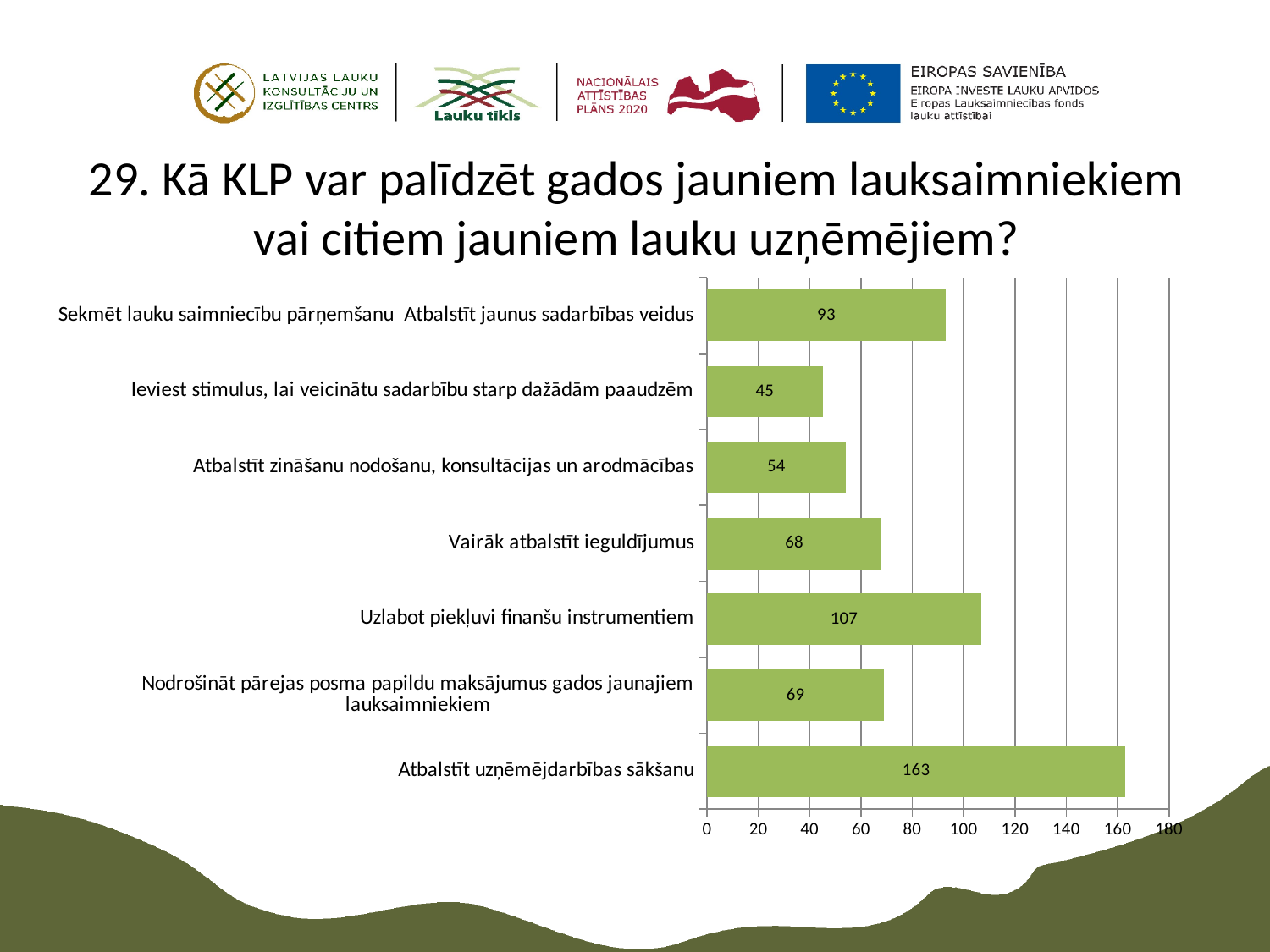
Which is larger: the value for "Atbalstīt zināšanu nodošanu, konsultācijas un arodmācības" or the value for "Vairāk atbalstīt ieguldījumus"? Vairāk atbalstīt ieguldījumus What kind of chart is shown on the slide? bar chart How many categories are shown in the chart? 7 Which category has the highest value? Atbalstīt uzņēmējdarbības sākšanu What is the difference between the values for "Atbalstīt uzņēmējdarbības sākšanu" and "Uzlabot piekļuvi finanšu instrumentiem"? 56 What value is shown for "Ieviest stimulus, lai veicinātu sadarbību starp dažādām paaudzēm"? 45 What value is shown for "Atbalstīt uzņēmējdarbības sākšanu"? 163 What value is shown for "Vairāk atbalstīt ieguldījumus"? 68 What value is shown for "Uzlabot piekļuvi finanšu instrumentiem"? 107 What is the maximum value shown on the horizontal axis? 180 Is the value for "Nodrošināt pārejas posma papildu maksājumus gados jaunajiem lauksaimniekiem" greater or less than 80? less Which category has the lowest value? Ieviest stimulus, lai veicinātu sadarbību starp dažādām paaudzēm